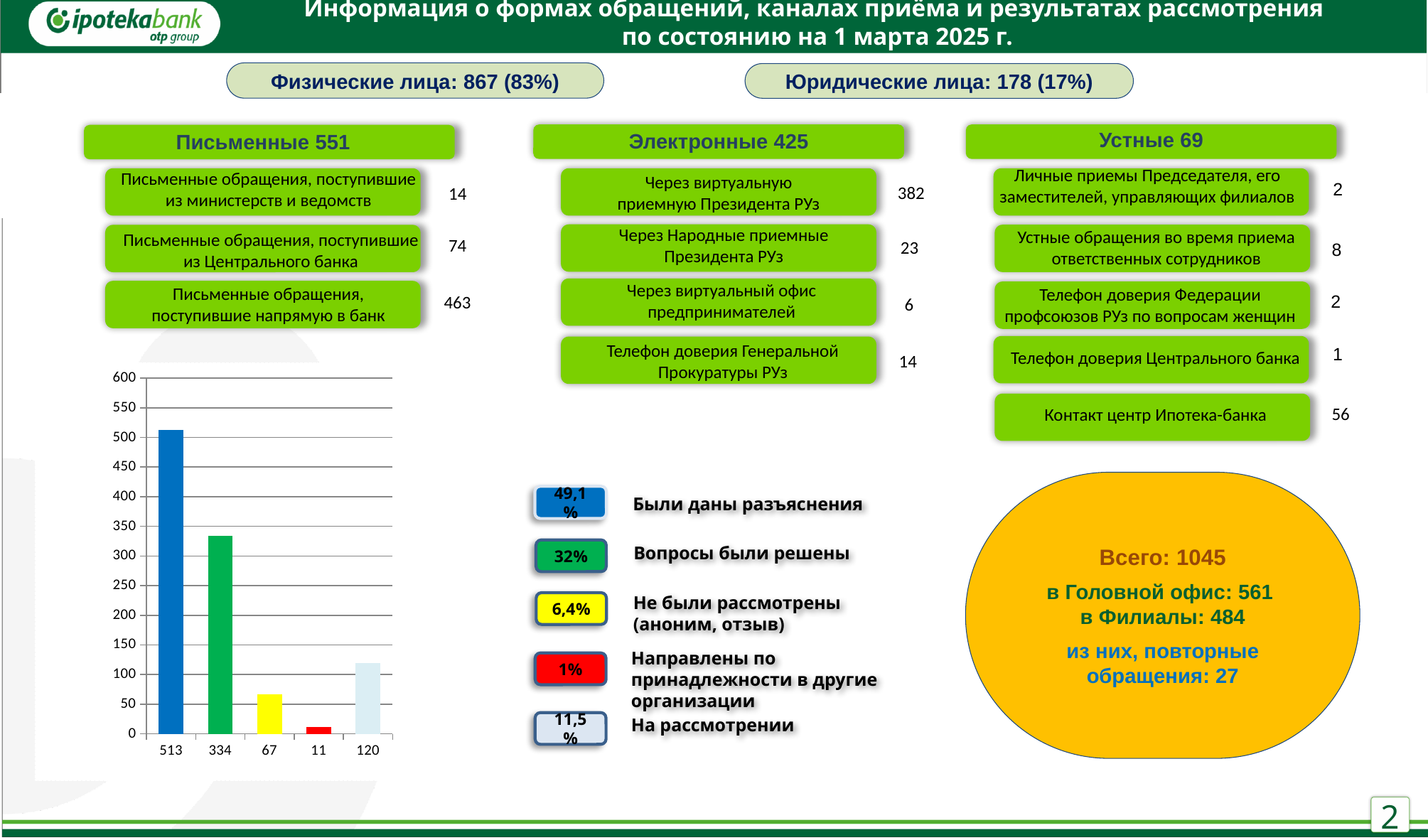
Which bar in the bar chart is the lowest? the red bar (11) What is the highest value shown on the vertical axis of the bar chart? 600 What kind of chart is shown at the bottom left of the slide? bar chart In the bar chart, what value is labelled under the light blue (last) bar? 120 How many bars does the bar chart at the bottom left contain? 5 In the bar chart, what value is labelled under the green bar? 334 In the bar chart, which is larger: the yellow bar or the light blue bar? the light blue bar (120) In the bar chart, what value is labelled under the tallest (blue) bar? 513 In the bar chart, what value is labelled under the red bar? 11 Which bar in the bar chart is the highest? the blue bar (513) What is the difference between the blue bar (513) and the green bar (334) in the bar chart? 179 According to the legend next to the bar chart, what percentage corresponds to the green colour (Вопросы были решены)? 32%